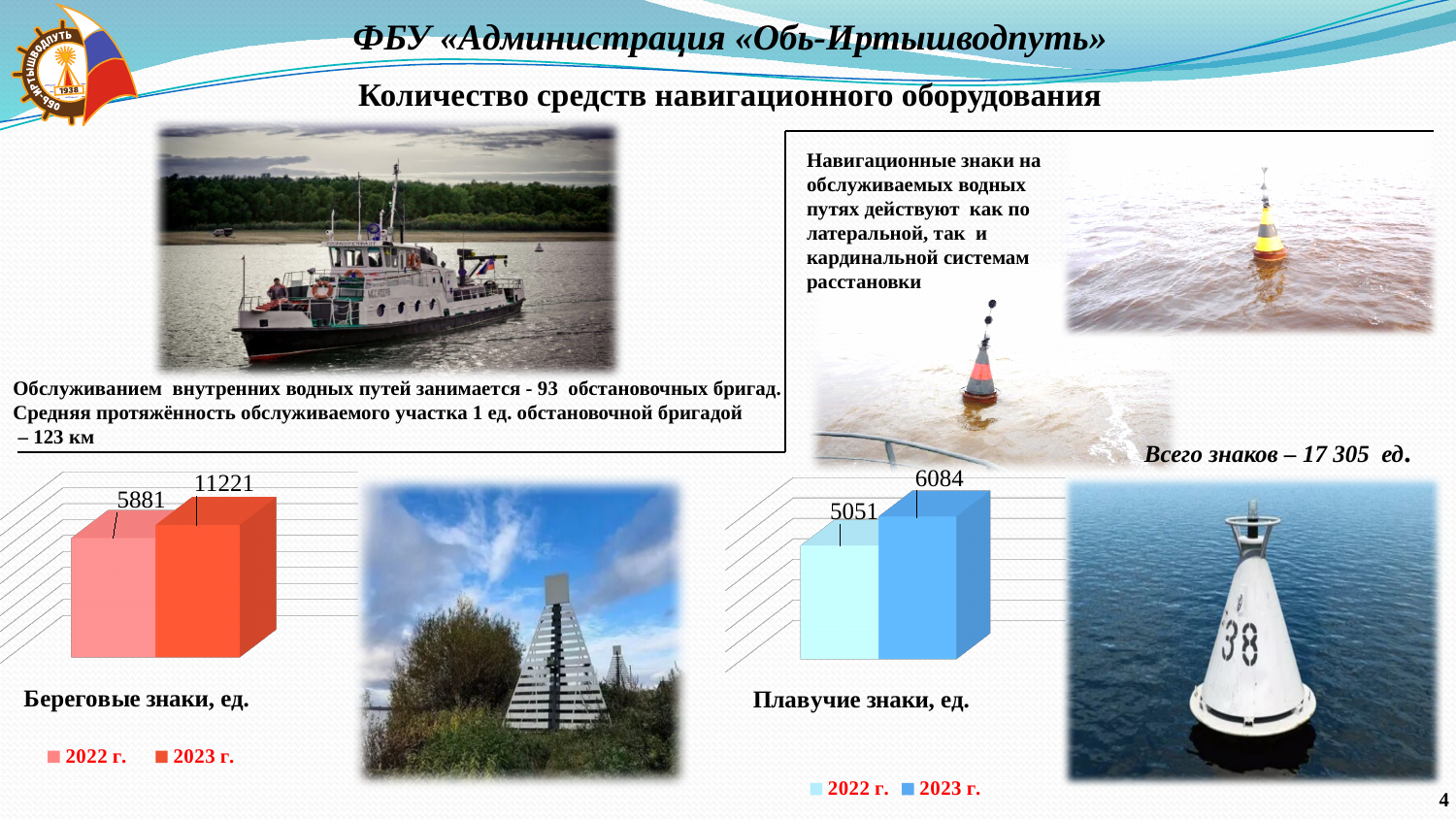
In the 'Береговые знаки, ед.' chart, which year has the higher value? 2023 г. How many series does the legend of the 'Плавучие знаки, ед.' chart list? 2 What kind of chart is the 'Береговые знаки, ед.' chart? bar chart In the 'Плавучие знаки, ед.' chart, what is the difference between the 2023 г. and 2022 г. values? 1033 In the 'Плавучие знаки, ед.' chart, which year has the lower value? 2022 г. Is the 2022 г. value in the 'Береговые знаки, ед.' chart larger or smaller than the 2022 г. value in the 'Плавучие знаки, ед.' chart? larger In the 'Береговые знаки, ед.' chart, what is the value for 2022 г.? 5881 In the 'Плавучие знаки, ед.' chart, what is the value for 2022 г.? 5051 In the 'Береговые знаки, ед.' chart, what is the value for 2023 г.? 11221 In the 'Плавучие знаки, ед.' chart, what is the value for 2023 г.? 6084 In the 'Береговые знаки, ед.' chart, what is the difference between the 2023 г. and 2022 г. values? 5340 In the 'Плавучие знаки, ед.' chart, do the values rise or fall from 2022 г. to 2023 г.? rise